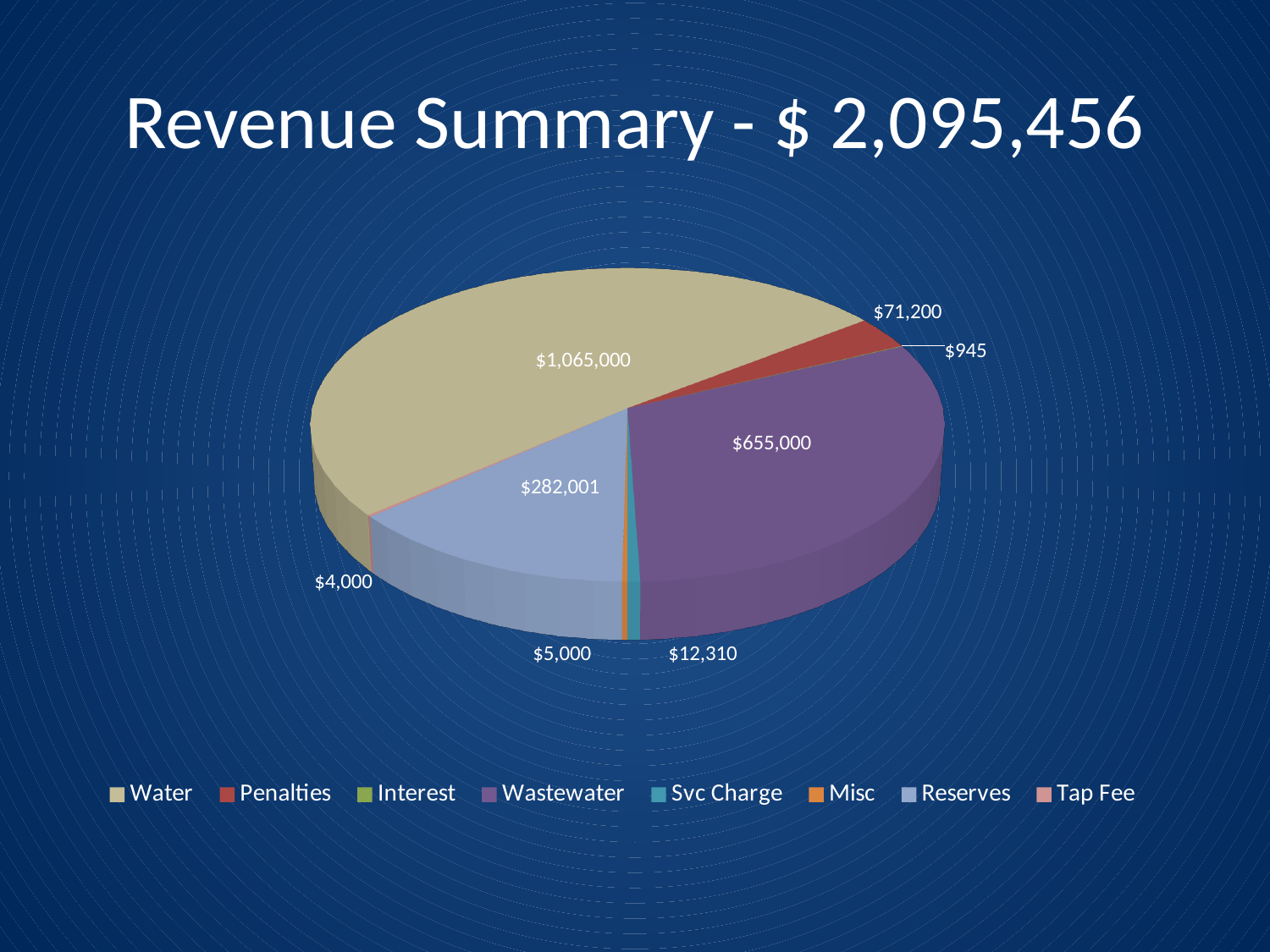
What total revenue is stated in the chart title? $ 2,095,456 What is the revenue value for Water? $1,065,000 Which category has the largest slice of the pie? Water What is the revenue value for Penalties? $71,200 What is the revenue value for Reserves? $282,001 Which is larger, Reserves or Penalties? Reserves What type of chart is shown on the slide? pie chart What is the difference between the Water and Wastewater values? $410,000 How many categories does the legend list? 8 What is the revenue value for Wastewater? $655,000 Which category has the smallest slice of the pie? Interest What is the revenue value for Svc Charge? $12,310